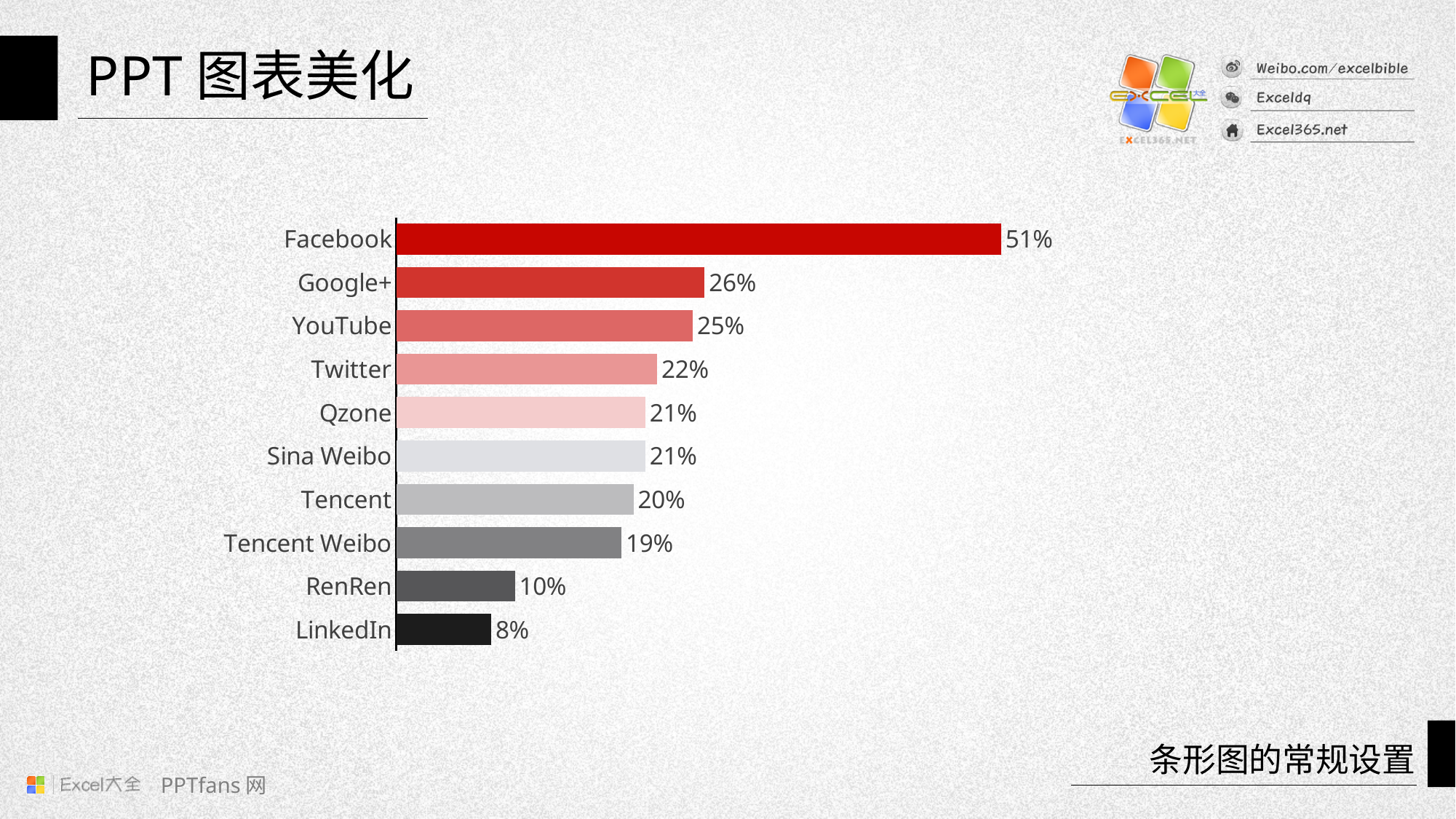
What is the value for Facebook? 51% Which category has the highest value? Facebook What is the difference between the values for RenRen and LinkedIn? 2% How many categories are shown in the chart? 10 Which category has the lowest value? LinkedIn What is the value for Tencent Weibo? 19% What is the value for LinkedIn? 8% What is the difference between the values for Facebook and Google+? 25% Which two categories share the same value of 21%? Qzone and Sina Weibo Which is larger, the value for Twitter or the value for Tencent? Twitter What colour is the Facebook bar? Red What kind of chart is shown on the slide? Bar chart